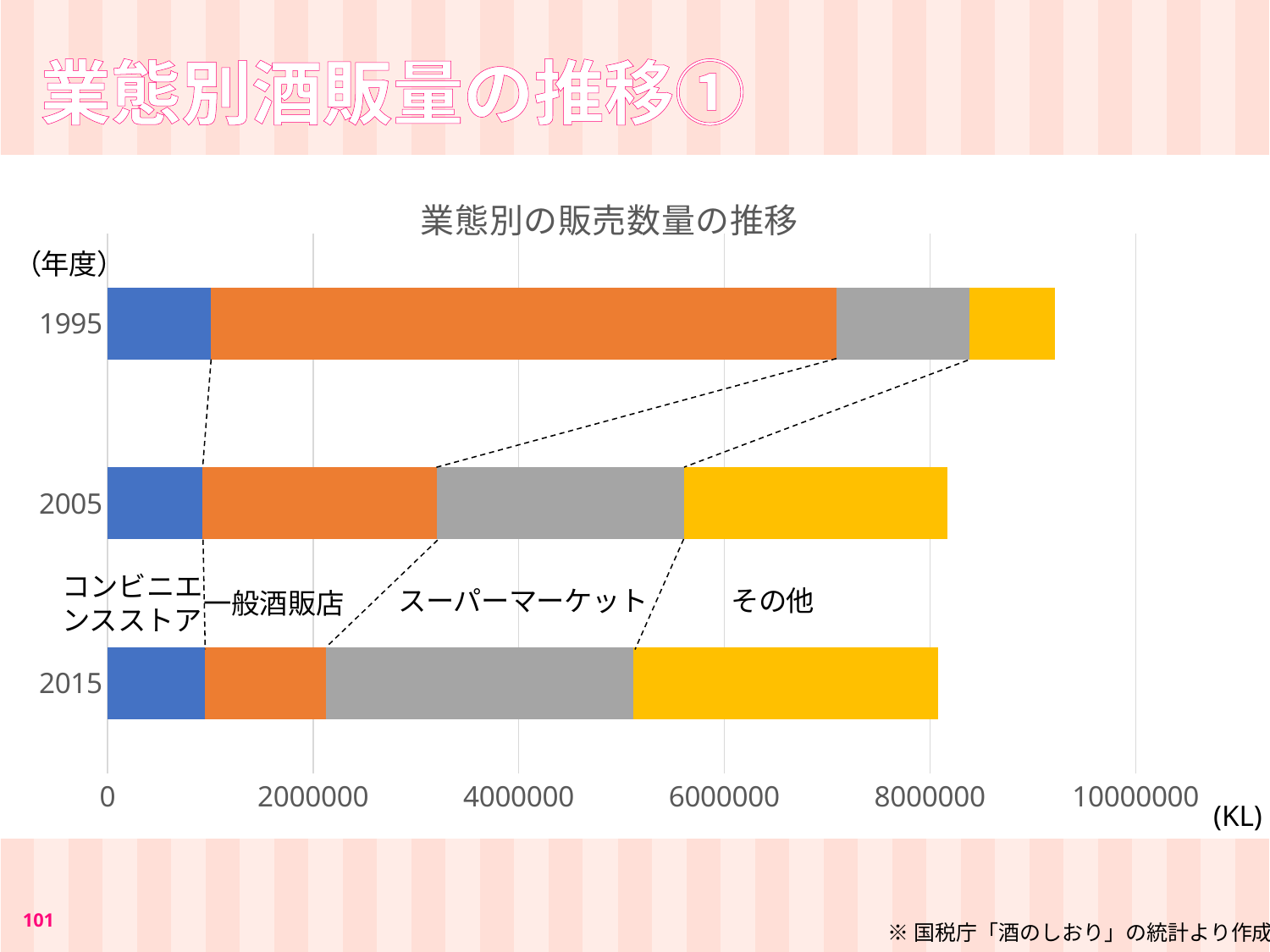
What unit is shown next to the horizontal axis? (KL) Is the total for 1995 greater or less than 8000000? greater Which year has the longest total bar? 1995 How many years (categories) are plotted in the chart? 3 What kind of chart is shown on the slide? stacked bar chart Which is larger, the total bar for 1995 or the total bar for 2015? 1995 Is the 一般酒販店 value for 1995 greater or less than 4000000? greater Does the 一般酒販店 segment rise or fall from 1995 to 2015? fall Which series has the largest segment in the 1995 bar? 一般酒販店 Is the スーパーマーケット value for 2015 greater or less than 2000000? greater How many series does the chart's legend list? 4 What is the title of the chart? 業態別の販売数量の推移